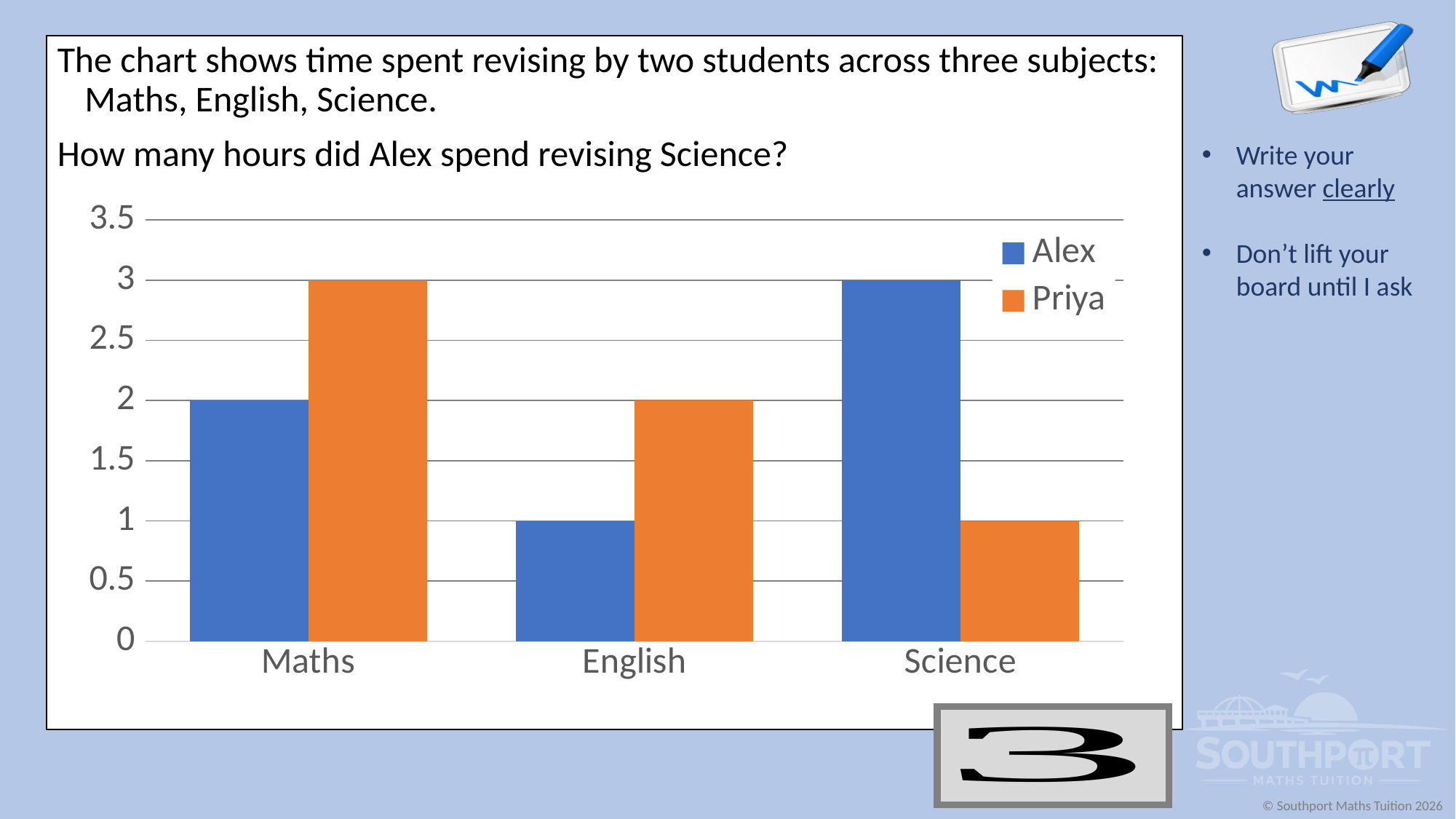
How many hours did Priya spend revising Science? 1 How many series does the legend list? 2 How many hours did Alex spend revising Science? 3 What kind of chart is shown? bar chart In which subject did Alex spend the most time revising? Science Which colour represents Priya in the chart? orange How many hours did Priya spend revising Maths? 3 How many hours did Alex spend revising English? 1 Who spent more hours revising English, Alex or Priya? Priya What is the difference between Priya's and Alex's revision hours for Maths? 1 In which subject did Priya spend the least time revising? Science How many subjects are shown on the x axis? 3